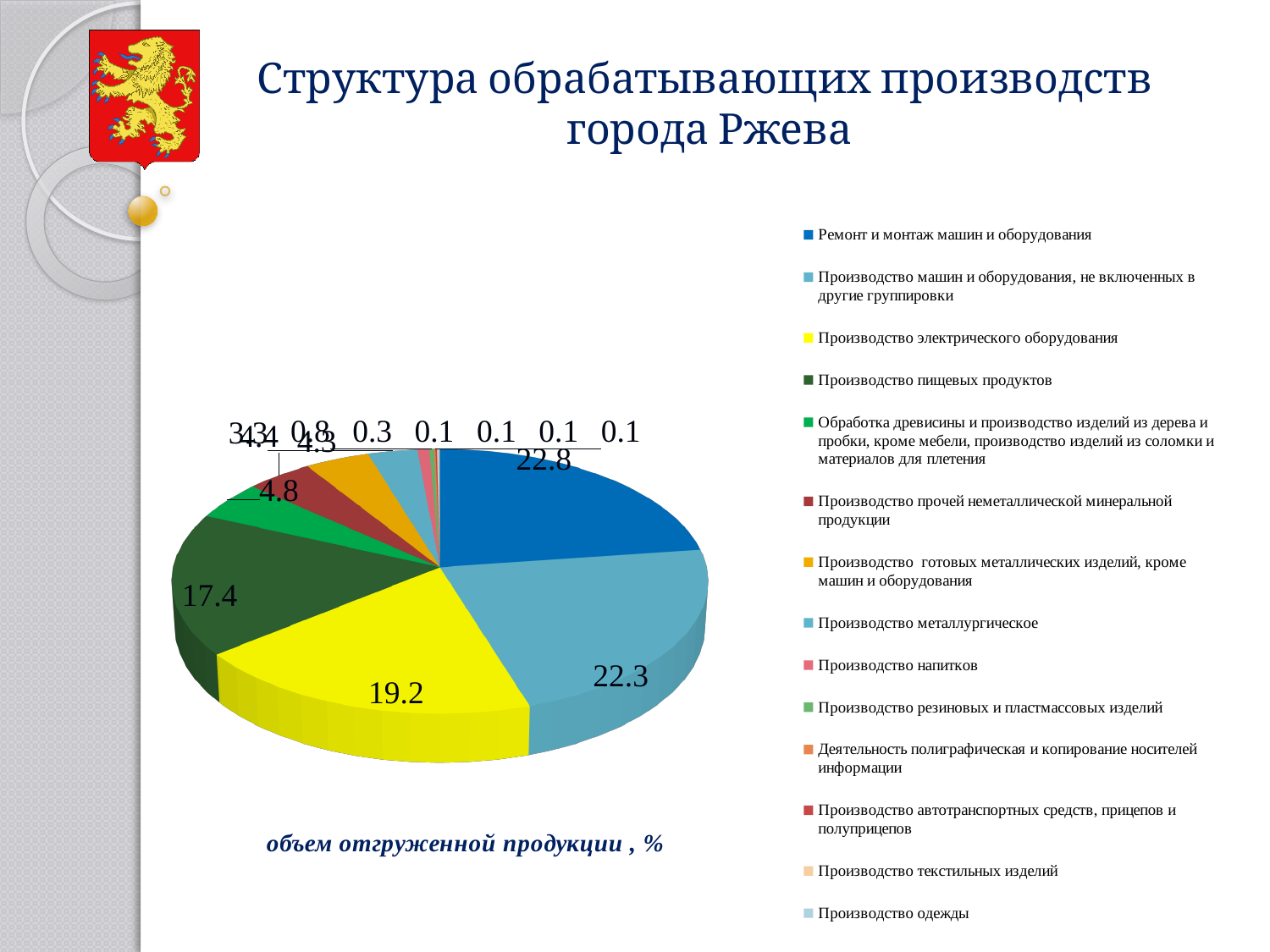
What is the value for «Производство напитков»? 0.8 How many categories does the legend list? 14 What is the difference between the values for «Ремонт и монтаж машин и оборудования» and «Производство пищевых продуктов»? 5.4 What is the value for «Производство электрического оборудования»? 19.2 What is the value for «Ремонт и монтаж машин и оборудования»? 22.8 What is the value for «Производство машин и оборудования, не включенных в другие группировки»? 22.3 What is the value for «Обработка древесины и производство изделий из дерева и пробки, кроме мебели, производство изделий из соломки и материалов для плетения»? 4.8 What kind of chart is shown on the slide? pie chart What caption is written below the pie chart? объем отгруженной продукции , % Which category has the largest slice of the pie? Ремонт и монтаж машин и оборудования Which is larger: «Производство электрического оборудования» or «Производство пищевых продуктов»? Производство электрического оборудования What is the value for «Производство пищевых продуктов»? 17.4